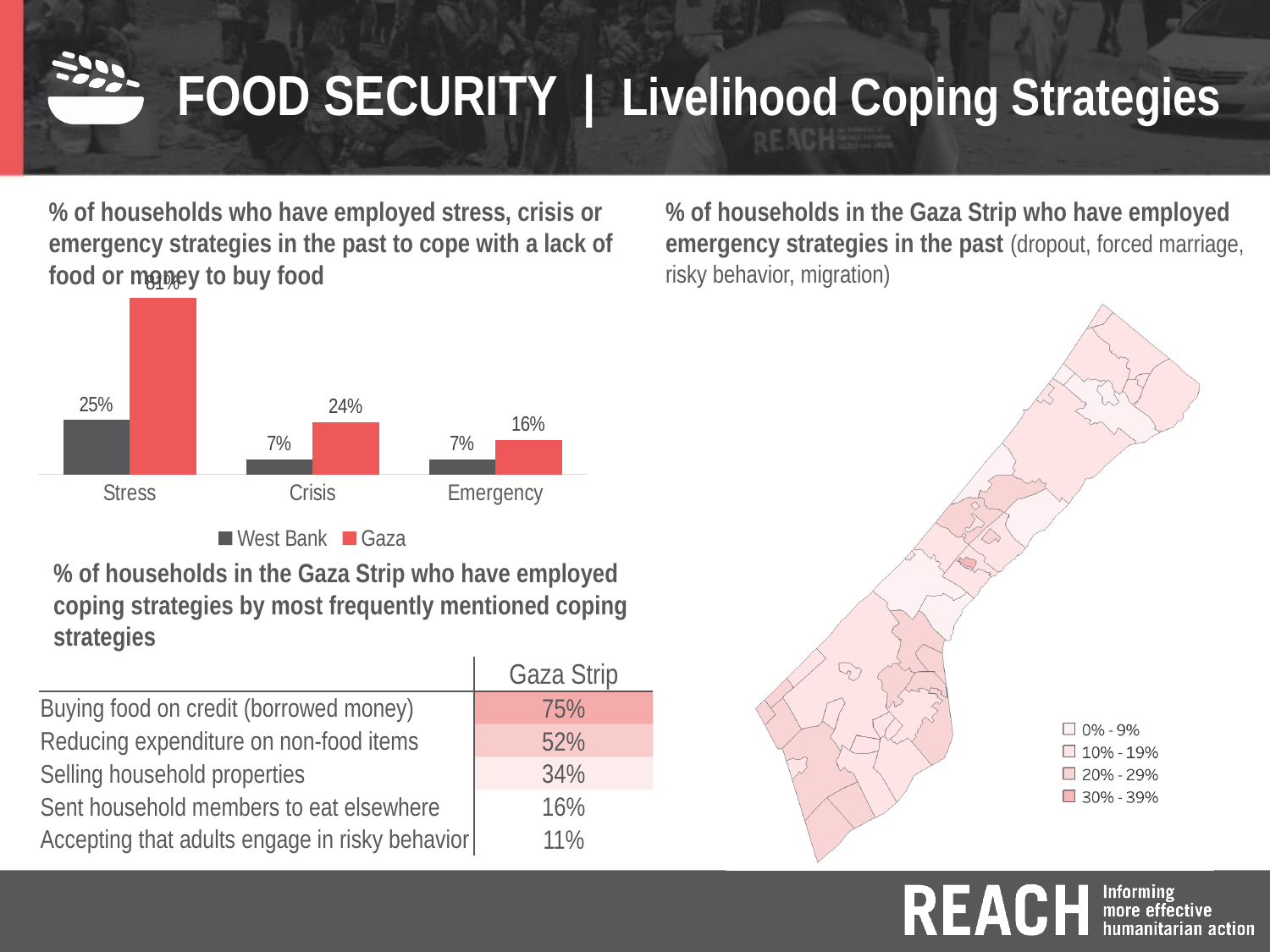
In the bar chart on the left, which category has the highest Gaza value? Stress In the bar chart on the left, what is the value for West Bank under Stress? 25% In the bar chart on the left, what is the value for Gaza under Crisis? 24% In the bar chart on the left, what is the value for West Bank under Emergency? 7% What type of chart is shown on the left of the slide? Bar chart In the bar chart on the left, which series is shown in red? Gaza In the bar chart on the left, how many categories are shown on the x axis? 3 In the bar chart on the left, what is the difference between the Gaza and West Bank values under Emergency? 9% In the bar chart on the left, which is larger under Stress: West Bank or Gaza? Gaza In the bar chart on the left, what is the value for Gaza under Emergency? 16% In the bar chart on the left, what is the difference between the Gaza and West Bank values under Crisis? 17% In the bar chart on the left, how many series does the legend list? 2